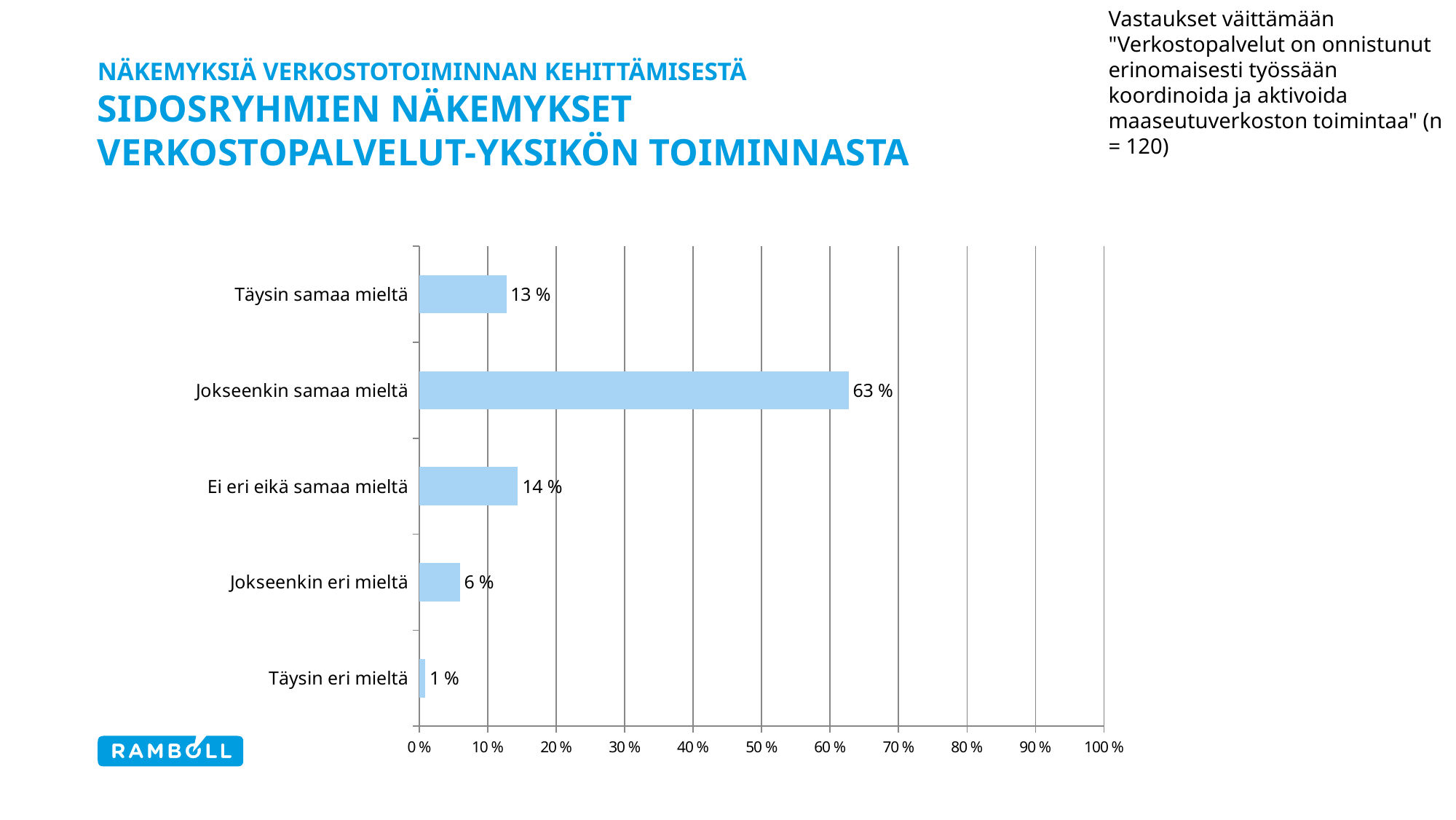
What is the value for "Täysin samaa mieltä"? 13 % Which is larger, the value for "Ei eri eikä samaa mieltä" or the value for "Jokseenkin eri mieltä"? Ei eri eikä samaa mieltä What kind of chart is shown on the slide? Bar chart What is the value for "Jokseenkin eri mieltä"? 6 % What is the value for "Jokseenkin samaa mieltä"? 63 % How many categories are shown in the chart? 5 Which category has the highest value? Jokseenkin samaa mieltä What is the difference between the values for "Jokseenkin samaa mieltä" and "Täysin samaa mieltä"? 50 % What is the value for "Täysin eri mieltä"? 1 % Is the value for "Jokseenkin samaa mieltä" greater or less than 50 %? greater Which category has the lowest value? Täysin eri mieltä What is the value for "Ei eri eikä samaa mieltä"? 14 %